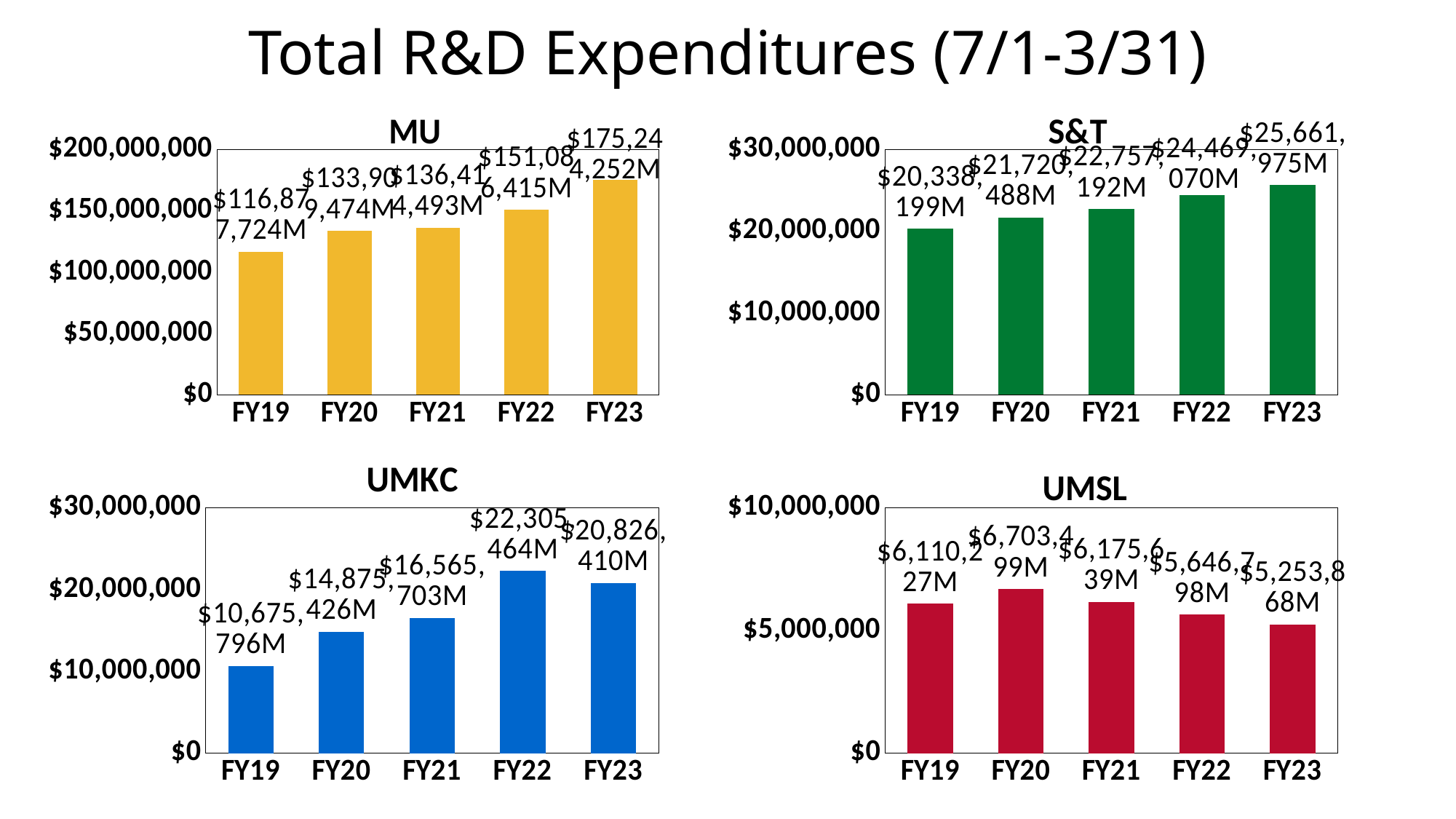
How many fiscal years are shown in the UMSL chart? 5 In the MU chart, what is the value for FY23? $175,244,252M In the UMKC chart, which fiscal year has the highest value? FY22 In the MU chart, is the value for FY19 greater or less than $100,000,000? greater In the UMKC chart, what is the value for FY19? $10,675,796M In the S&T chart, what is the difference between the FY23 and FY19 values? $5,323,776M In the UMKC chart, which is larger, the value for FY22 or FY23? FY22 In the UMSL chart, which fiscal year has the lowest value? FY23 In the UMSL chart, what is the value for FY20? $6,703,499M In the S&T chart, do the values rise or fall from FY19 to FY23? rise In the S&T chart, what is the value for FY23? $25,661,975M What kind of chart is the S&T chart? bar chart